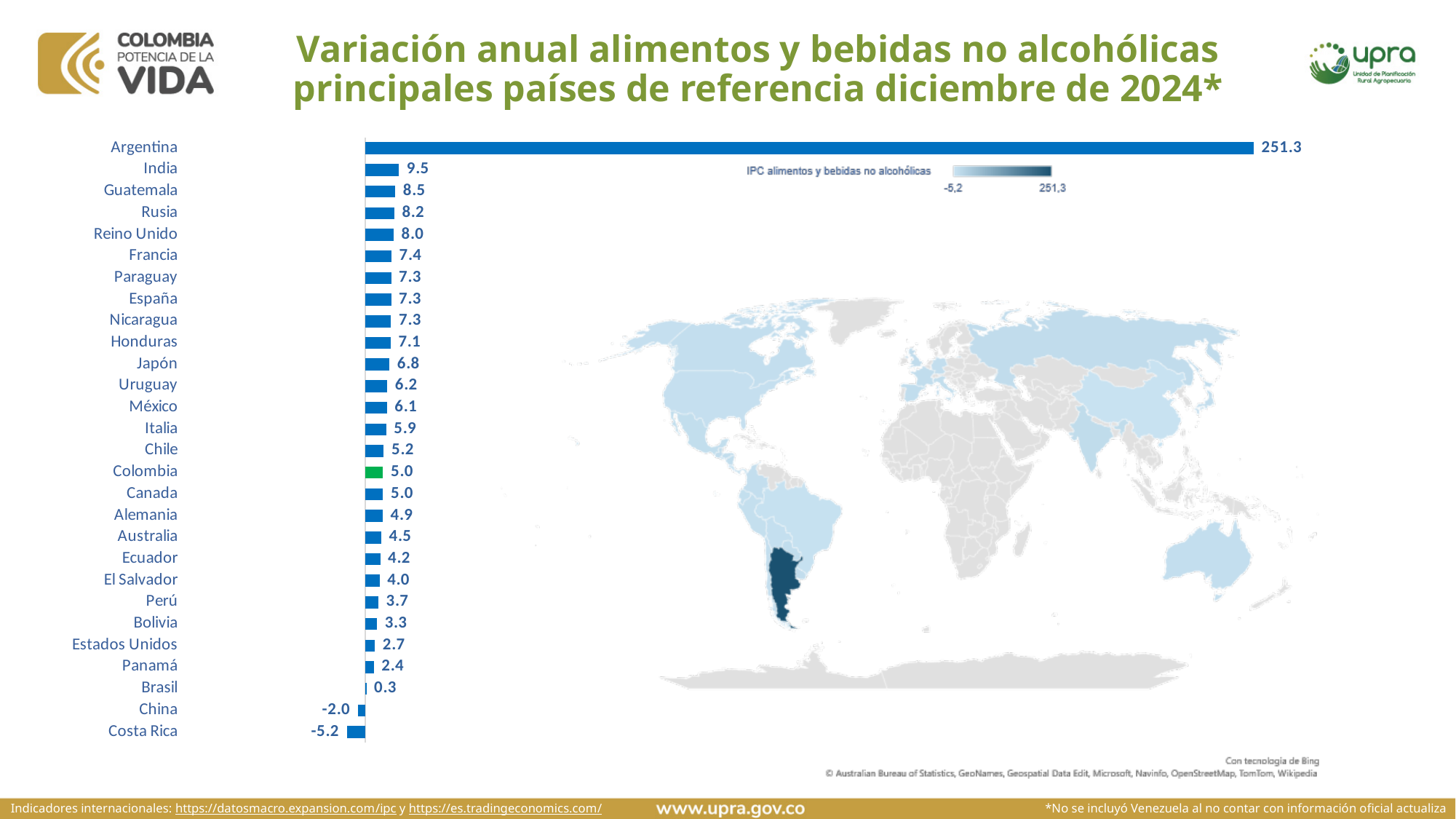
Which country has the lowest value in the bar chart? Costa Rica What kind of chart is used to show the annual variation by country? Bar chart What is the value shown for Colombia in the bar chart? 5.0 What is the value shown for Argentina in the bar chart? 251.3 How many countries are shown in the bar chart? 28 What is the difference between the values for Argentina and Costa Rica in the bar chart? 256.5 Which has a larger value in the bar chart, Chile or Perú? Chile What is the difference between the values for India and Guatemala in the bar chart? 1.0 Which country's bar is coloured green in the bar chart? Colombia Which country has the highest value in the bar chart? Argentina What is the value shown for Costa Rica in the bar chart? -5.2 What is the value shown for Japón in the bar chart? 6.8